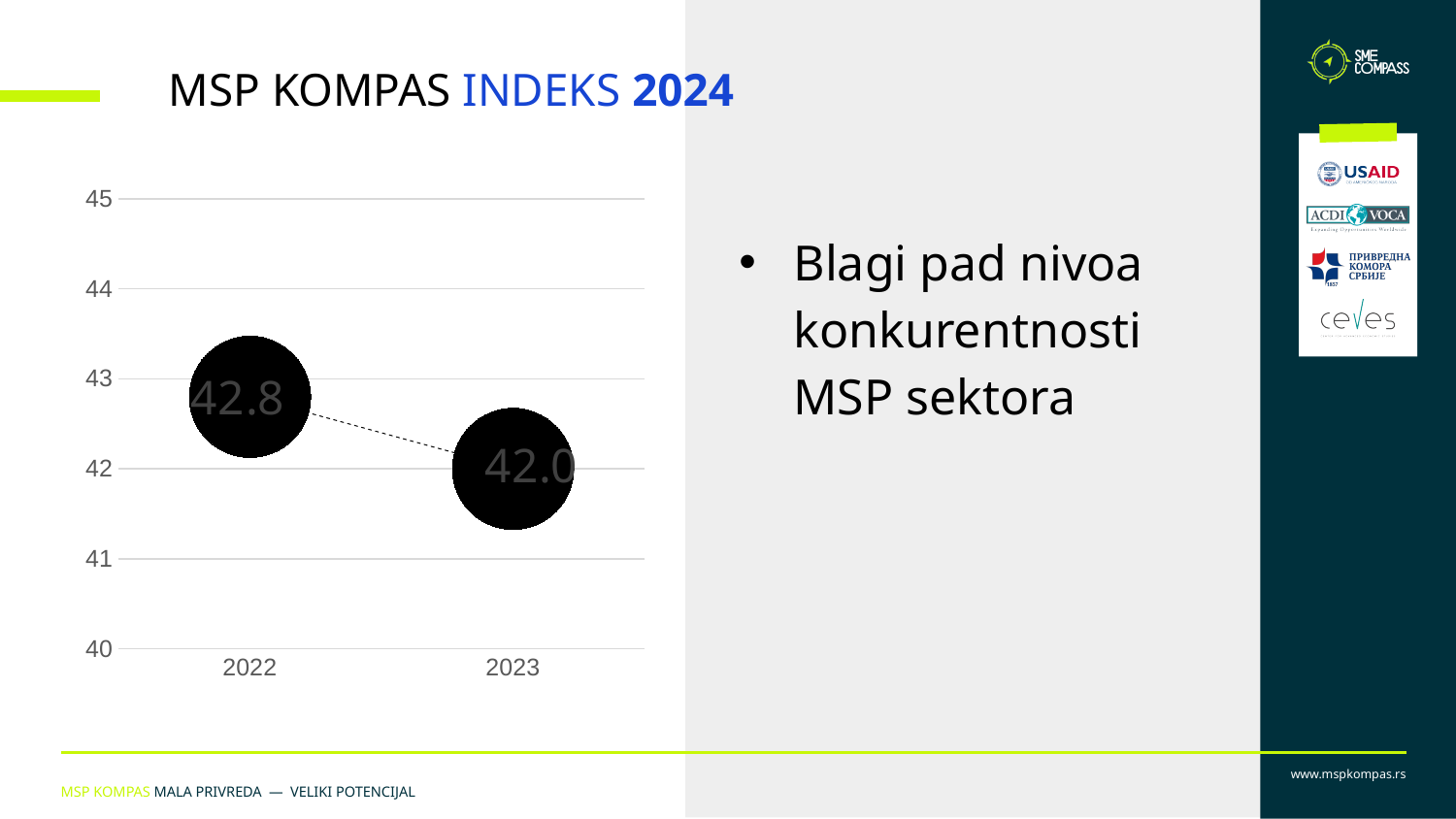
Do the values rise or fall from 2022 to 2023? fall What is the difference between the 2022 and 2023 values? 0.8 What is the highest value shown on the vertical axis? 45 Which year has the higher value? 2022 Is the value for 2022 greater or less than 43? less How many data points are plotted in the chart? 2 Which year has the lower value? 2023 What is the value for 2022? 42.8 Is the value for 2022 larger or smaller than the value for 2023? larger What is the value for 2023? 42.0 What is the lowest value shown on the vertical axis? 40